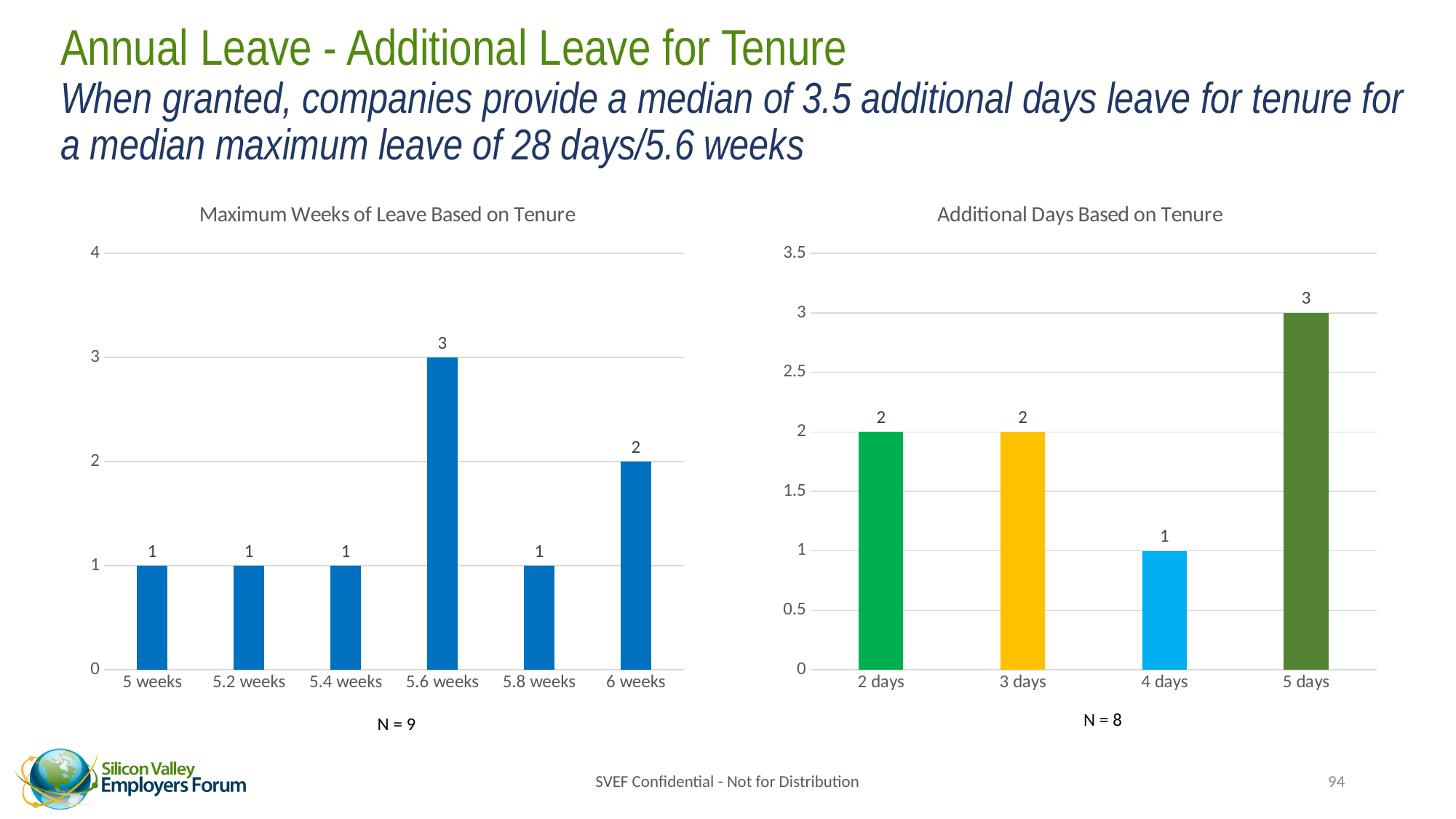
In the 'Additional Days Based on Tenure' chart, what is the value for 5 days? 3 In the 'Maximum Weeks of Leave Based on Tenure' chart, what is the difference between the values for 5.6 weeks and 6 weeks? 1 In the 'Additional Days Based on Tenure' chart, what is the value for 4 days? 1 What kind of chart is the 'Additional Days Based on Tenure' chart? Bar chart In the 'Additional Days Based on Tenure' chart, how many categories are shown on the x axis? 4 In the 'Maximum Weeks of Leave Based on Tenure' chart, what is the value for 6 weeks? 2 In the 'Maximum Weeks of Leave Based on Tenure' chart, which category has the highest value? 5.6 weeks In the 'Maximum Weeks of Leave Based on Tenure' chart, how many categories are shown on the x axis? 6 In the 'Additional Days Based on Tenure' chart, which is larger, the value for 2 days or the value for 5 days? 5 days In the 'Additional Days Based on Tenure' chart, which category has the lowest value? 4 days What is the N value shown below the 'Maximum Weeks of Leave Based on Tenure' chart? N = 9 In the 'Maximum Weeks of Leave Based on Tenure' chart, what is the value for 5.6 weeks? 3